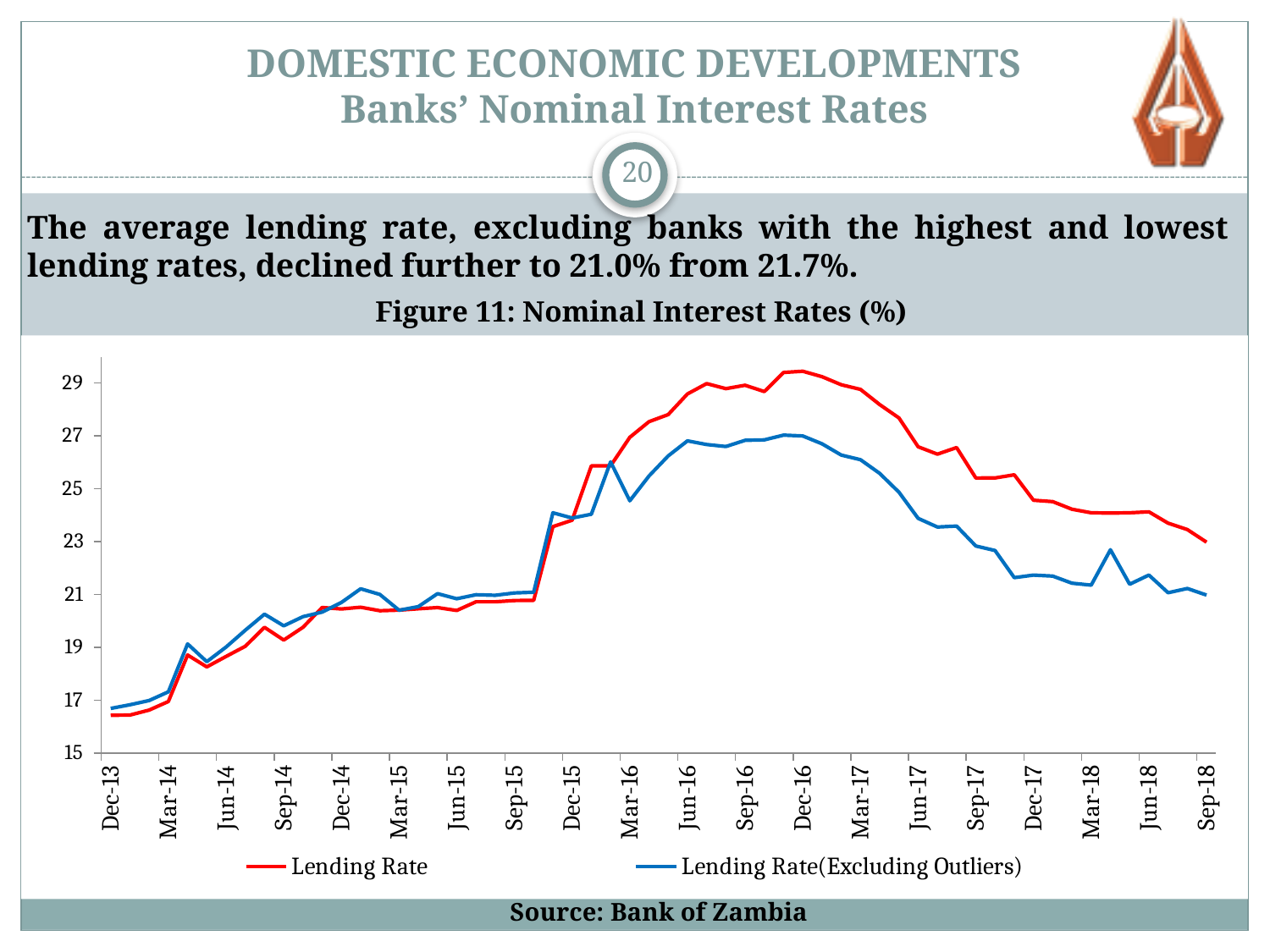
How many series does the legend list? 2 At Sep-18, which series is higher: Lending Rate or Lending Rate(Excluding Outliers)? Lending Rate What is the title of the chart? Figure 11: Nominal Interest Rates (%) Is the Lending Rate at Sep-18 greater or less than 25? less Does the Lending Rate rise or fall between Dec-16 and Sep-18? fall Is the Lending Rate at Dec-13 greater or less than 17? less Is the Lending Rate(Excluding Outliers) at Sep-18 greater or less than 23? less Does the Lending Rate(Excluding Outliers) rise or fall between Dec-13 and Dec-16? rise What are the two series named in the legend? Lending Rate; Lending Rate(Excluding Outliers) What kind of chart is shown in Figure 11? line chart How many date labels are shown on the x axis? 20